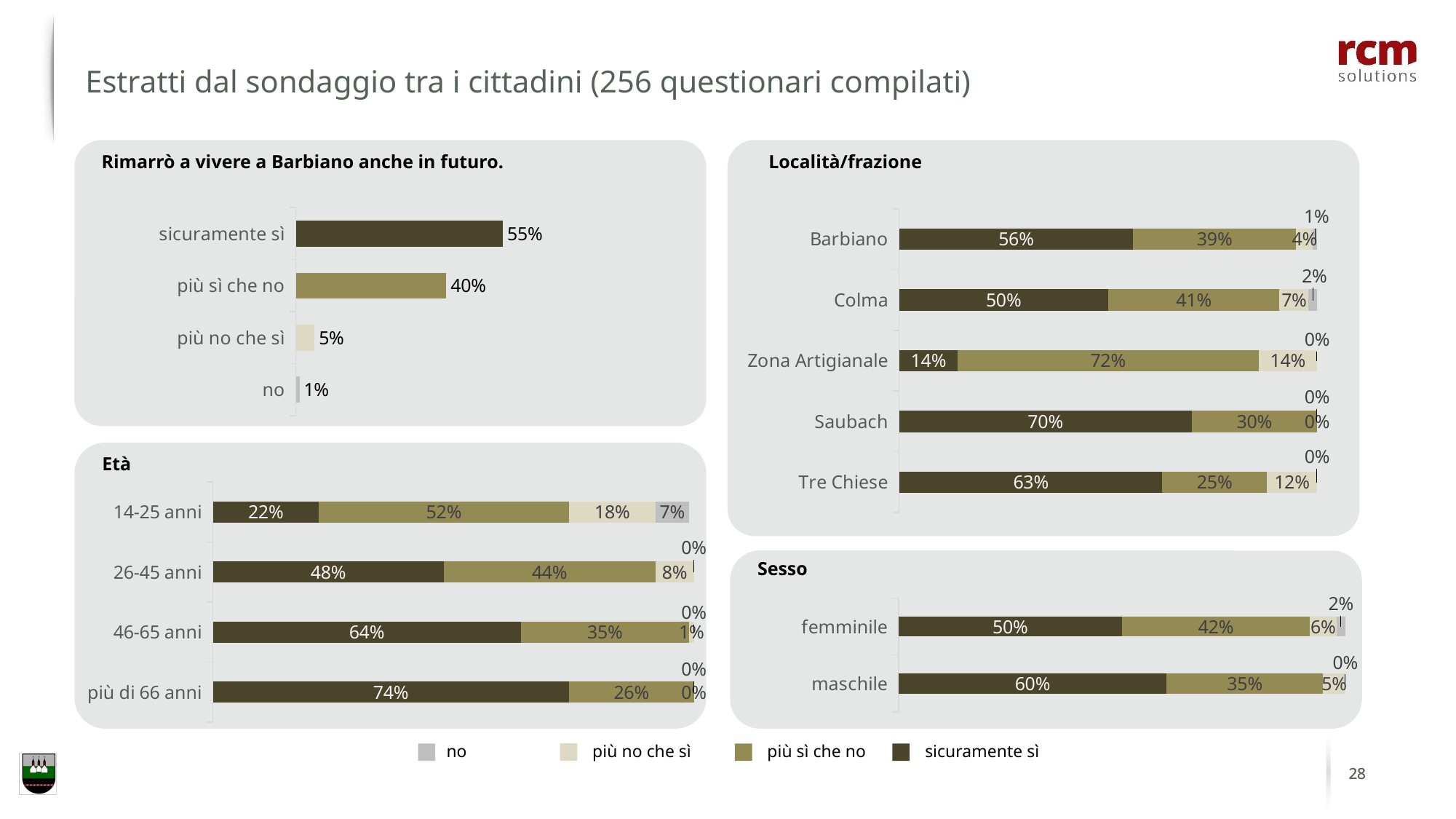
In the chart 'Rimarrò a vivere a Barbiano anche in futuro.', what is the difference between 'sicuramente sì' and 'più sì che no'? 15 percentage points In the 'Età' chart, what is the 'sicuramente sì' share for '46-65 anni'? 64% In the 'Località/frazione' chart, how many localities are listed? 5 In the chart 'Rimarrò a vivere a Barbiano anche in futuro.', which category has the lowest value? no In the chart 'Rimarrò a vivere a Barbiano anche in futuro.', which category has the highest value? sicuramente sì In the 'Località/frazione' chart, what is the 'più sì che no' share for 'Zona Artigianale'? 72% In the 'Sesso' chart, what is the difference between the 'sicuramente sì' shares for 'maschile' and 'femminile'? 10 percentage points How many series does the legend at the bottom of the slide list? 4 In the chart 'Rimarrò a vivere a Barbiano anche in futuro.', what is the value for 'più sì che no'? 40% In the 'Età' chart, how many age groups are shown? 4 In the 'Località/frazione' chart, which has the larger 'sicuramente sì' share, Saubach or Tre Chiese? Saubach In the 'Età' chart, which age group has the highest 'sicuramente sì' share? più di 66 anni